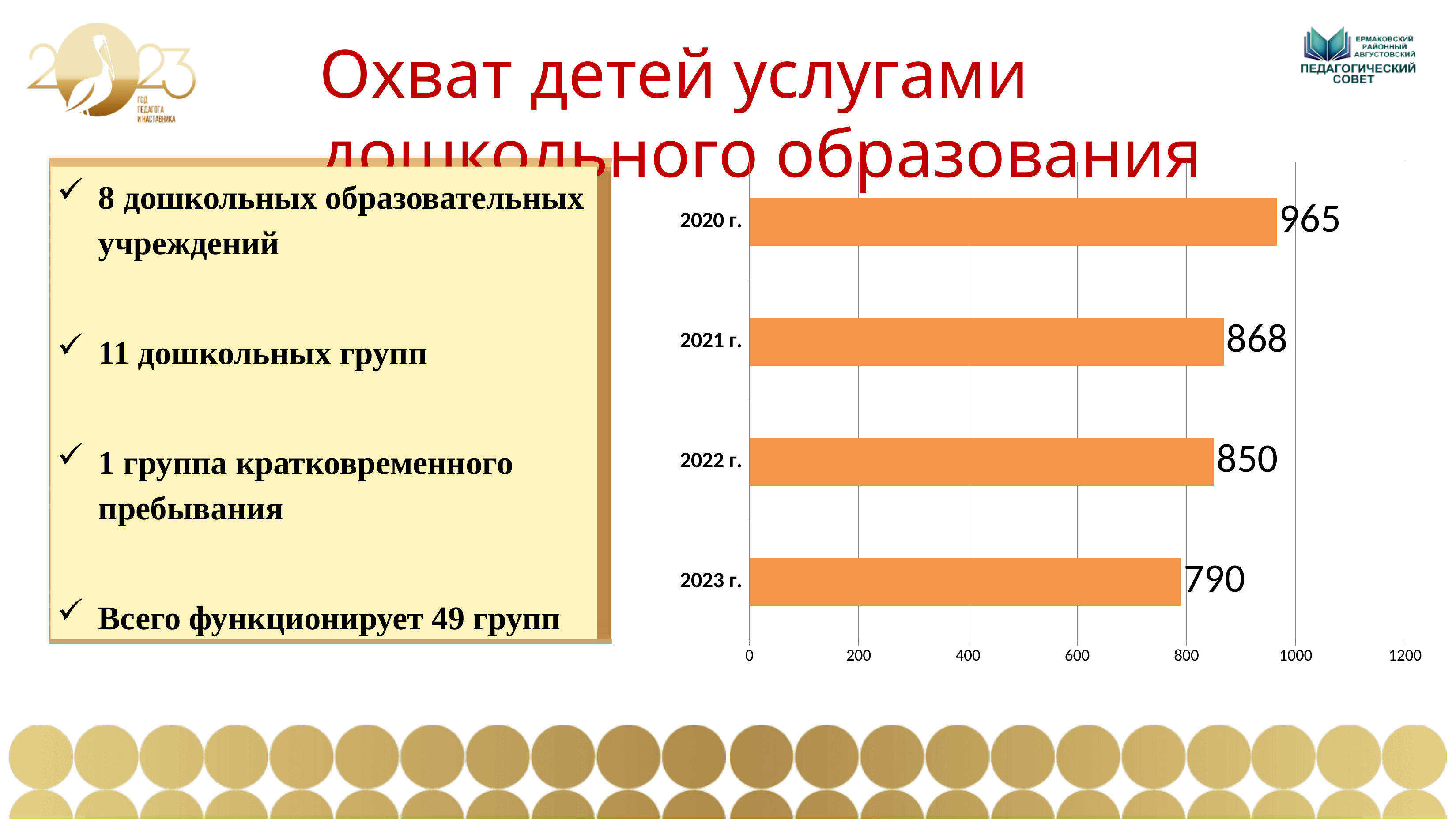
Is the value for 2023 г. greater or less than 800? less Which year has the lowest value? 2023 г. What is the difference between the values for 2021 г. and 2022 г.? 18 What is the value for 2023 г.? 790 Which is larger, the value for 2021 г. or the value for 2023 г.? 2021 г. What is the difference between the values for 2020 г. and 2023 г.? 175 What is the value for 2022 г.? 850 What kind of chart is shown on the slide? bar chart What is the value for 2021 г.? 868 What is the value for 2020 г.? 965 How many years are shown in the chart? 4 Which year has the highest value? 2020 г.